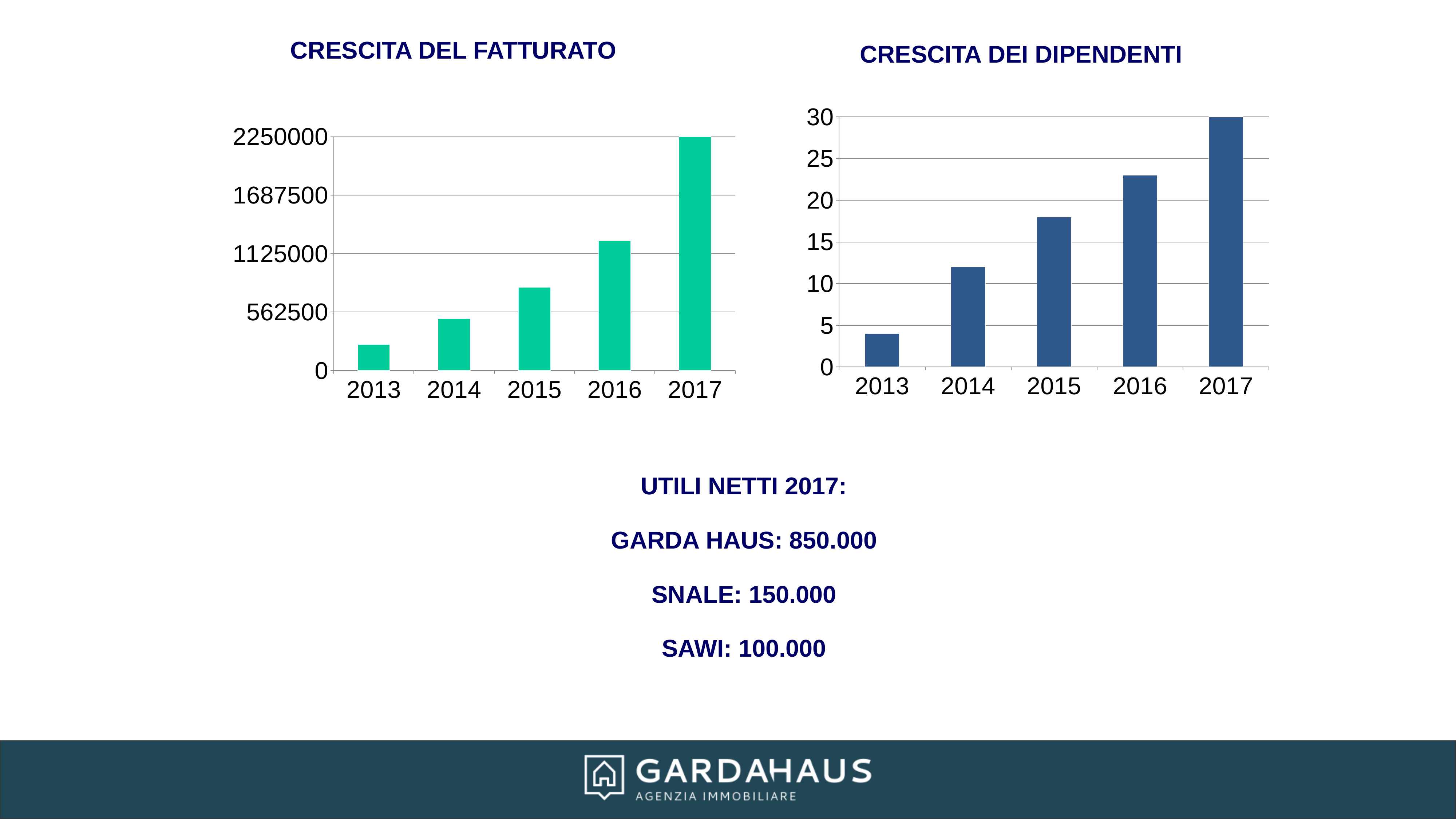
Do the values in the CRESCITA DEI DIPENDENTI chart rise or fall from 2013 to 2017? rise What colour are the bars in the CRESCITA DEL FATTURATO chart? green In the CRESCITA DEI DIPENDENTI chart, what is the value for 2017? 30 In the CRESCITA DEI DIPENDENTI chart, is the value for 2016 greater or less than 20? greater In the CRESCITA DEL FATTURATO chart, which year has the highest value? 2017 In the CRESCITA DEL FATTURATO chart, which is larger, the value for 2014 or the value for 2015? 2015 In the CRESCITA DEL FATTURATO chart, is the value for 2016 greater or less than 1125000? greater In the CRESCITA DEI DIPENDENTI chart, which year has the lowest value? 2013 How many years are shown on the CRESCITA DEI DIPENDENTI chart? 5 What kind of chart is CRESCITA DEL FATTURATO? bar chart In the CRESCITA DEI DIPENDENTI chart, is the value for 2013 greater or less than 5? less